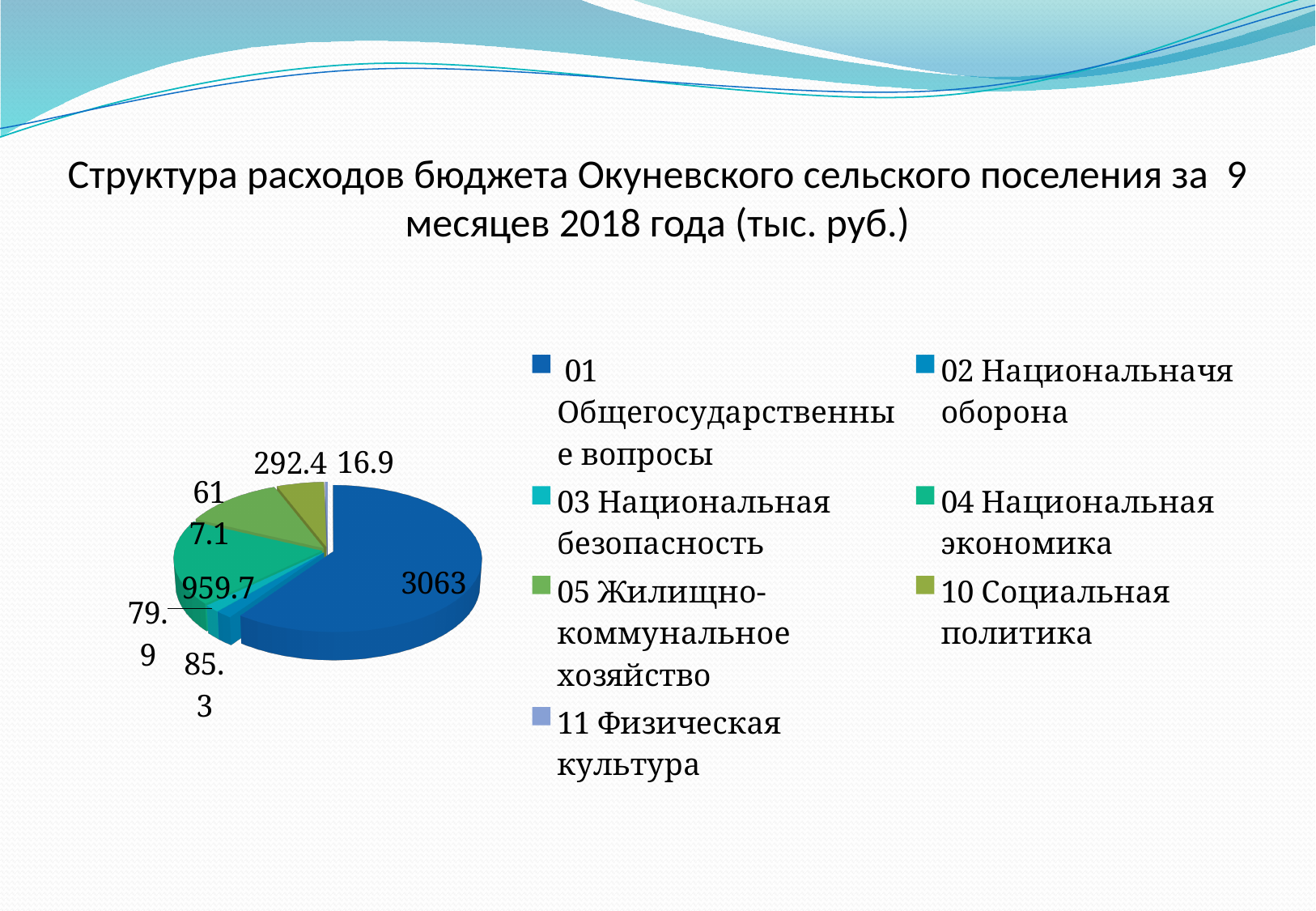
What is the value shown for 04 Национальная экономика? 959.7 What is the value shown for 11 Физическая культура? 16.9 Which category has the smallest slice of the pie? 11 Физическая культура Which is larger: the value for 04 Национальная экономика or for 10 Социальная политика? 04 Национальная экономика What is the value shown for 01 Общегосударственные вопросы? 3063 What is the difference between the values for 01 Общегосударственные вопросы and 10 Социальная политика? 2770.6 How many entries does the legend list? 7 What is the title of the slide's chart? Структура расходов бюджета Окуневского сельского поселения за 9 месяцев 2018 года (тыс. руб.) What is the value shown for 10 Социальная политика? 292.4 Which category has the largest slice of the pie? 01 Общегосударственные вопросы What type of chart is shown on the slide? Pie chart How many categories does the pie chart contain? 7